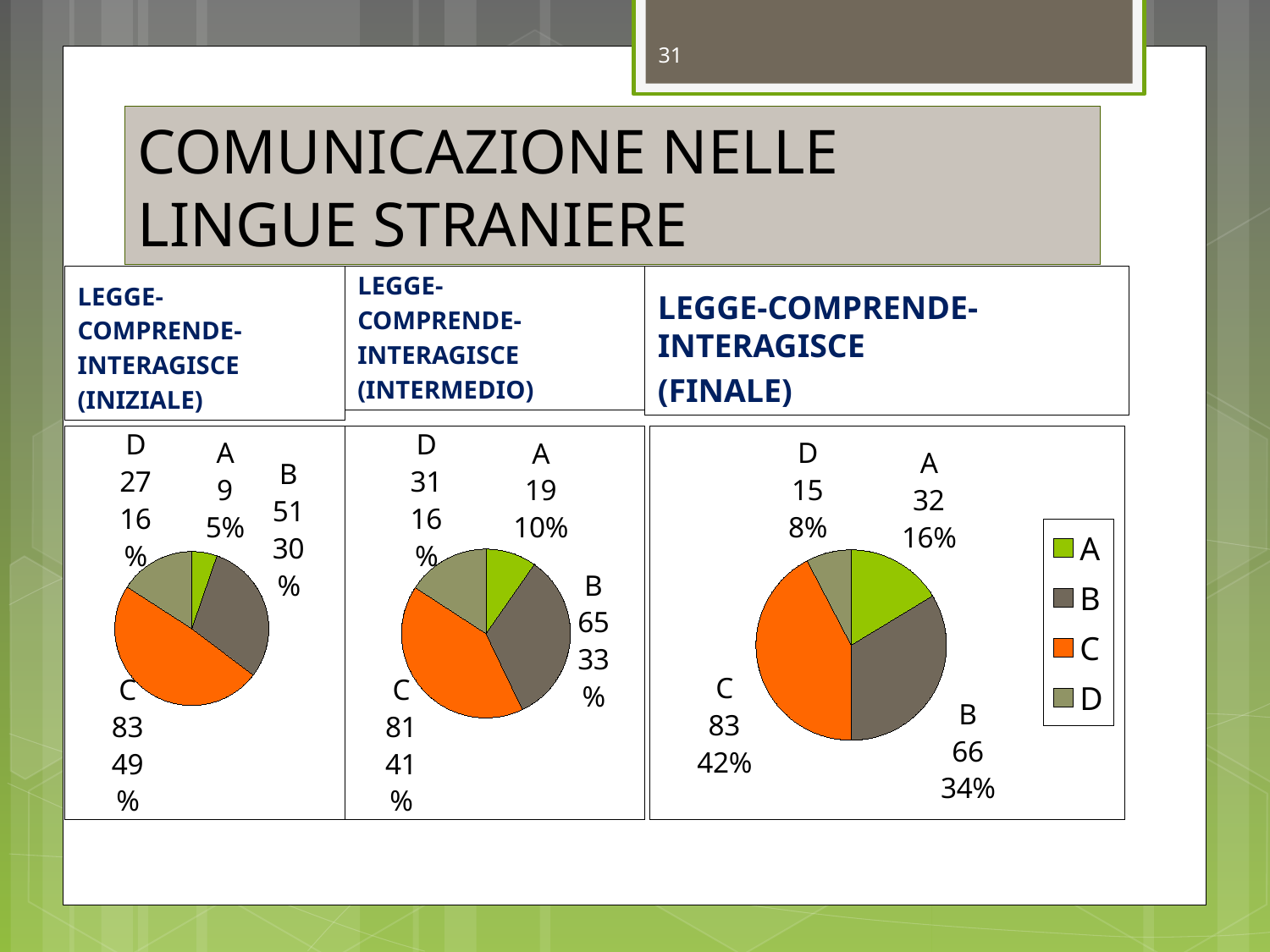
In the INTERMEDIO pie chart, what percentage share does category D have? 16% How many categories does the legend of the FINALE chart list? 4 In the INTERMEDIO pie chart, what value is shown for category B? 65 In the INIZIALE pie chart, what percentage share does category A have? 5% In the INTERMEDIO pie chart, which is larger, the value for A or the value for D? D In the FINALE pie chart, which category has the smallest slice? D What type of chart is used for the INIZIALE, INTERMEDIO and FINALE data? Pie chart In the FINALE pie chart, what is the difference between the values for C and B? 17 In the INIZIALE pie chart, what value is shown for category C? 83 In the FINALE pie chart, what value is shown for category A? 32 In the INIZIALE pie chart, which category has the largest slice? C In the FINALE pie chart, what percentage share does category C have? 42%